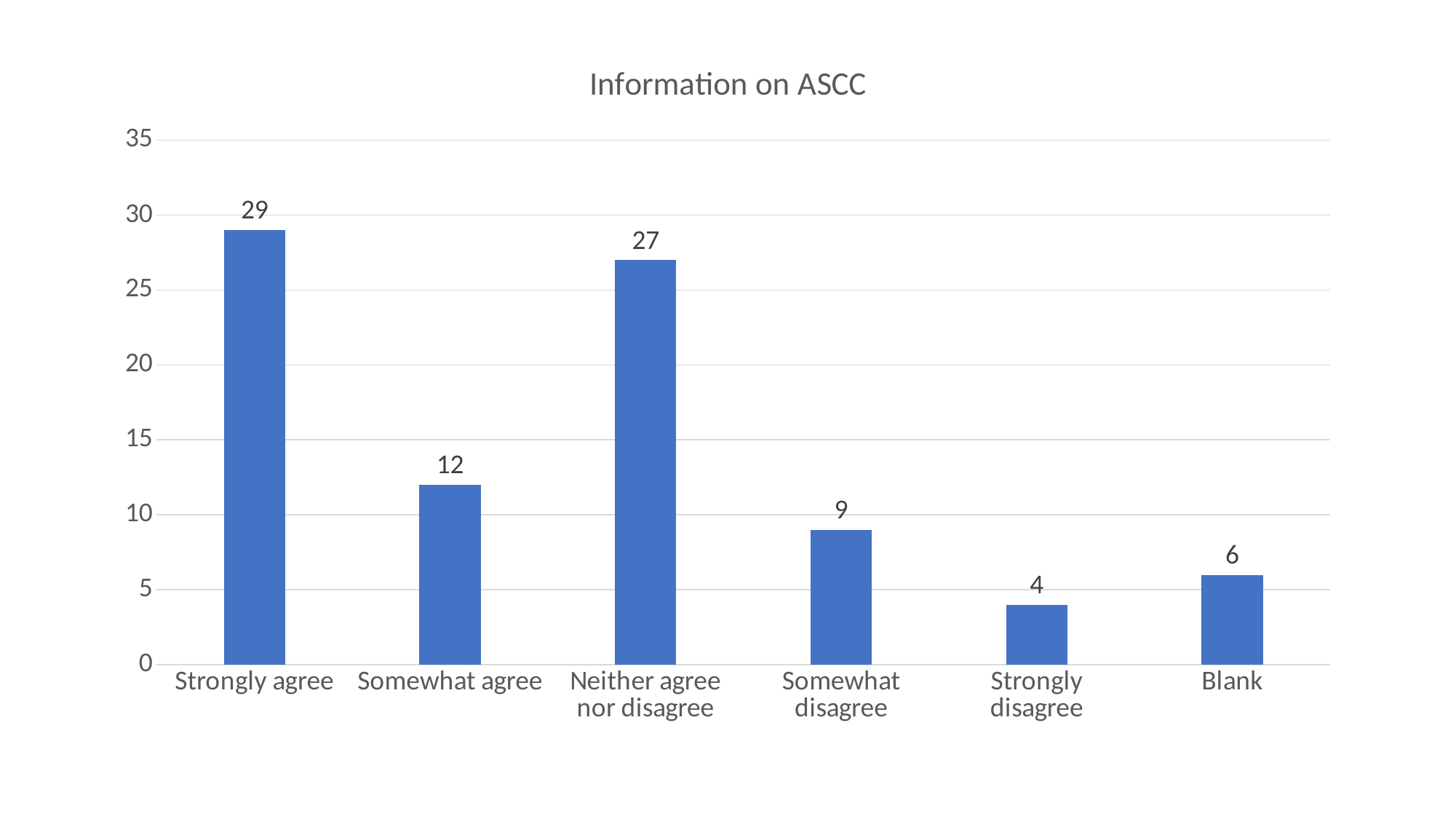
What kind of chart is shown on the slide? bar chart How many categories are shown on the x axis? 6 What is the difference between the values for Strongly agree and Somewhat agree? 17 What is the value for Strongly agree? 29 What is the value for Neither agree nor disagree? 27 Which is larger, the value for Somewhat agree or the value for Somewhat disagree? Somewhat agree What is the title of the chart? Information on ASCC Which category has the lowest value? Strongly disagree What is the value for Blank? 6 Which category has the highest value? Strongly agree What is the difference between the values for Somewhat disagree and Strongly disagree? 5 Is the value for Neither agree nor disagree greater or less than 25? greater